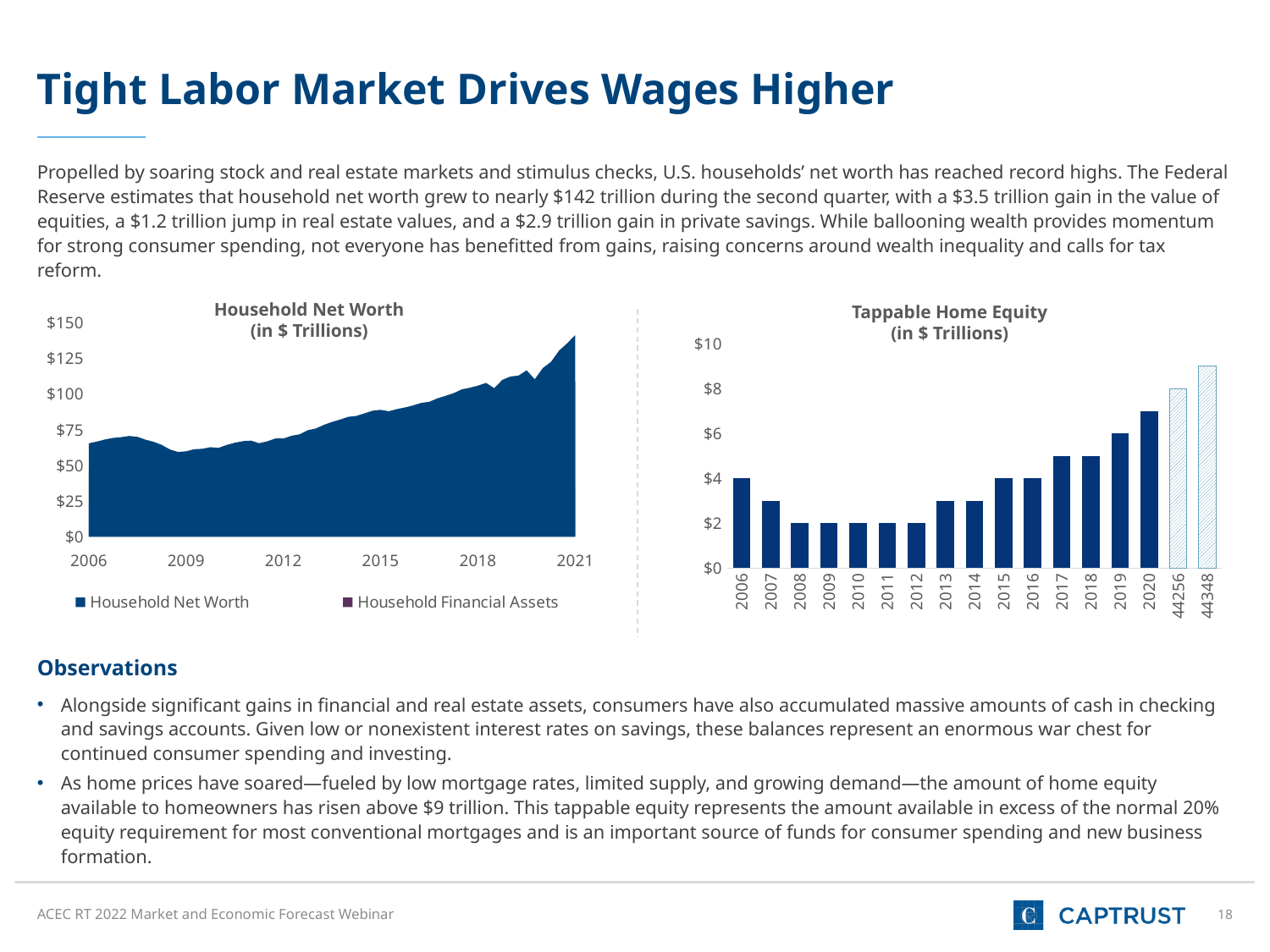
What type of chart is the Household Net Worth chart? area chart How many bars are plotted in the Tappable Home Equity chart? 17 How many series does the legend of the Household Net Worth chart list? 2 What type of chart is the Tappable Home Equity chart? bar chart In the Tappable Home Equity chart, is the value for 2020 greater or less than $6? greater In the Tappable Home Equity chart, which is larger, the value for 2006 or the value for 2020? 2020 In the Household Net Worth chart, do values generally rise or fall from 2006 to 2021? rise In the Tappable Home Equity chart, what is the value for 2008? $2 In the Tappable Home Equity chart, which category has the highest value? 44348 In the Tappable Home Equity chart, is the value for 2007 greater or less than $2? greater In the Household Net Worth chart, is the value at 2021 greater or less than $125? greater What unit is stated in the title of the Tappable Home Equity chart? $ Trillions